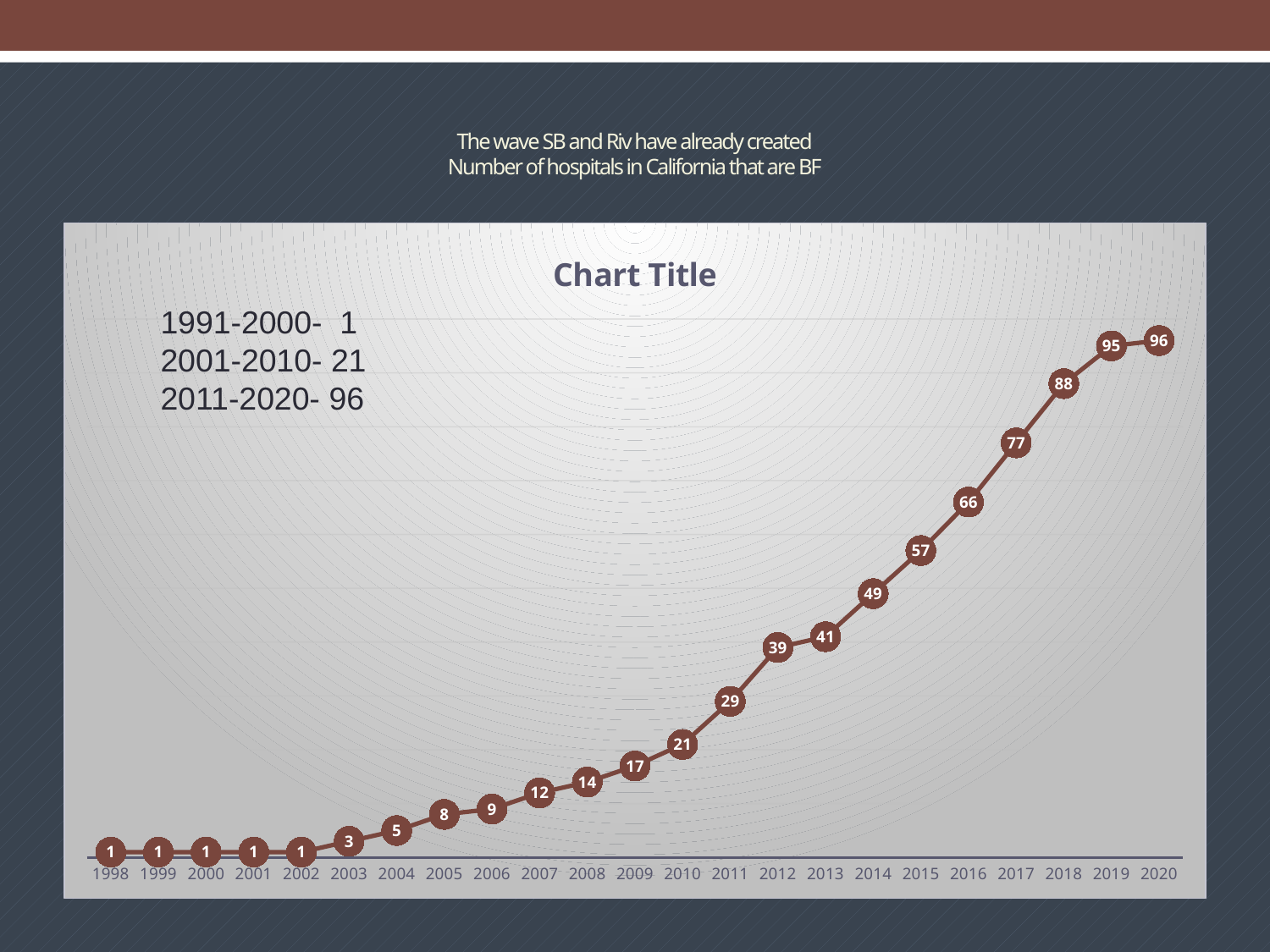
What is the title shown on the chart? Chart Title What is the value for 2003? 3 What is the value for 2010? 21 Which is larger, the value for 2012 or the value for 2013? 2013 What kind of chart is shown? line chart What is the highest value shown on the chart? 96 What is the difference between the values for 2020 and 2010? 75 What is the value for 2016? 66 Do the values rise or fall from 1998 to 2020? rise Which year has the highest value? 2020 How many years are plotted on the x axis? 23 What is the difference between the values for 2018 and 2017? 11